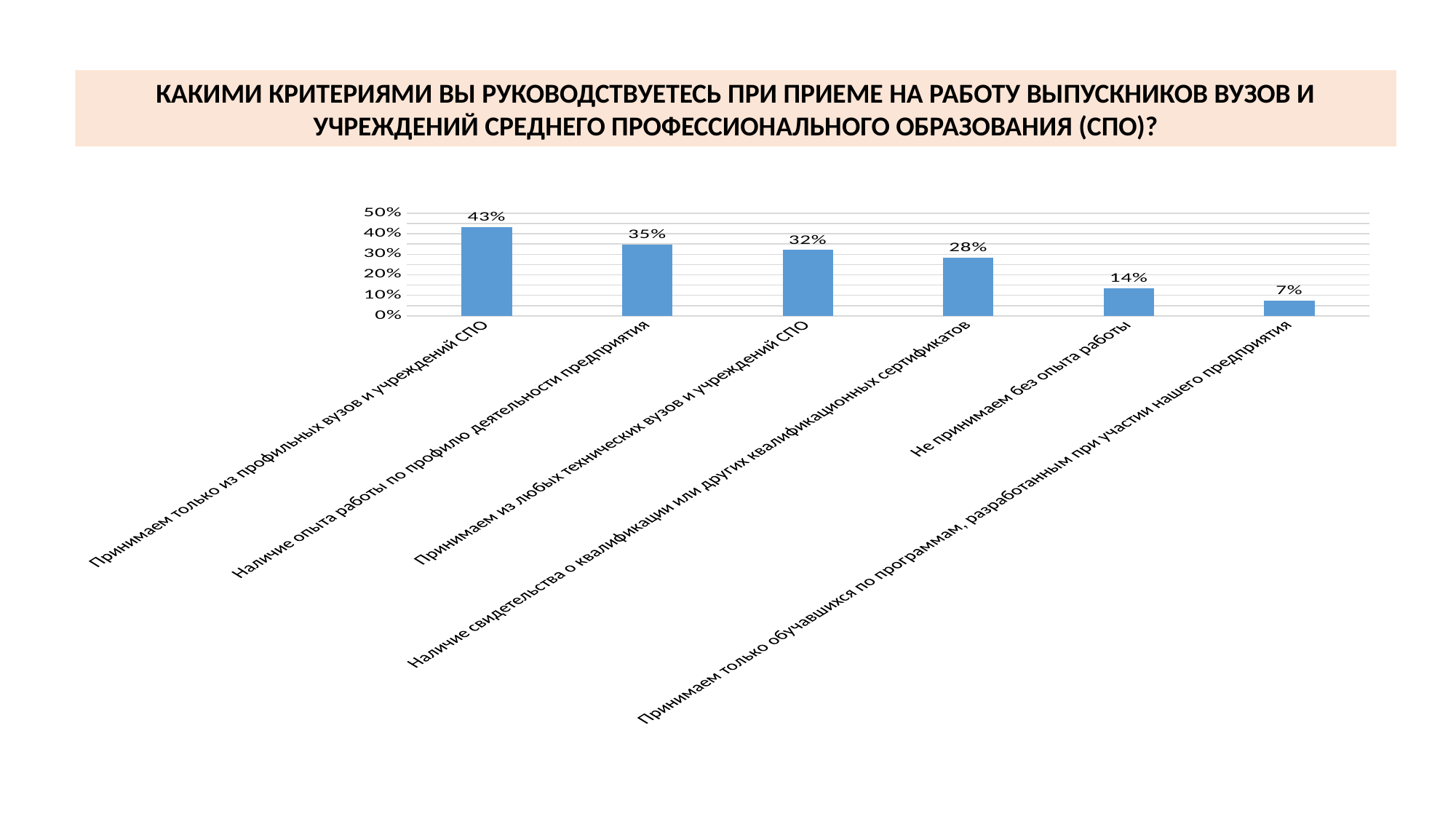
Which category has the lowest value? Принимаем только обучавшихся по программам, разработанным при участии нашего предприятия What is the difference between the values for "Принимаем только из профильных вузов и учреждений СПО" and "Наличие опыта работы по профилю деятельности предприятия"? 8% What is the value for "Наличие опыта работы по профилю деятельности предприятия"? 35% Which is larger: the value for "Принимаем из любых технических вузов и учреждений СПО" or the value for "Наличие свидетельства о квалификации или других квалификационных сертификатов"? Принимаем из любых технических вузов и учреждений СПО What is the value for "Принимаем только из профильных вузов и учреждений СПО"? 43% Do the values rise or fall from left to right along the x axis? Fall Which category has the highest value? Принимаем только из профильных вузов и учреждений СПО What is the value for "Принимаем только обучавшихся по программам, разработанным при участии нашего предприятия"? 7% How many categories are shown in the chart? 6 What kind of chart is shown on the slide? Bar chart What is the value for "Не принимаем без опыта работы"? 14% Is the value for "Наличие свидетельства о квалификации или других квалификационных сертификатов" greater or less than 20%? greater